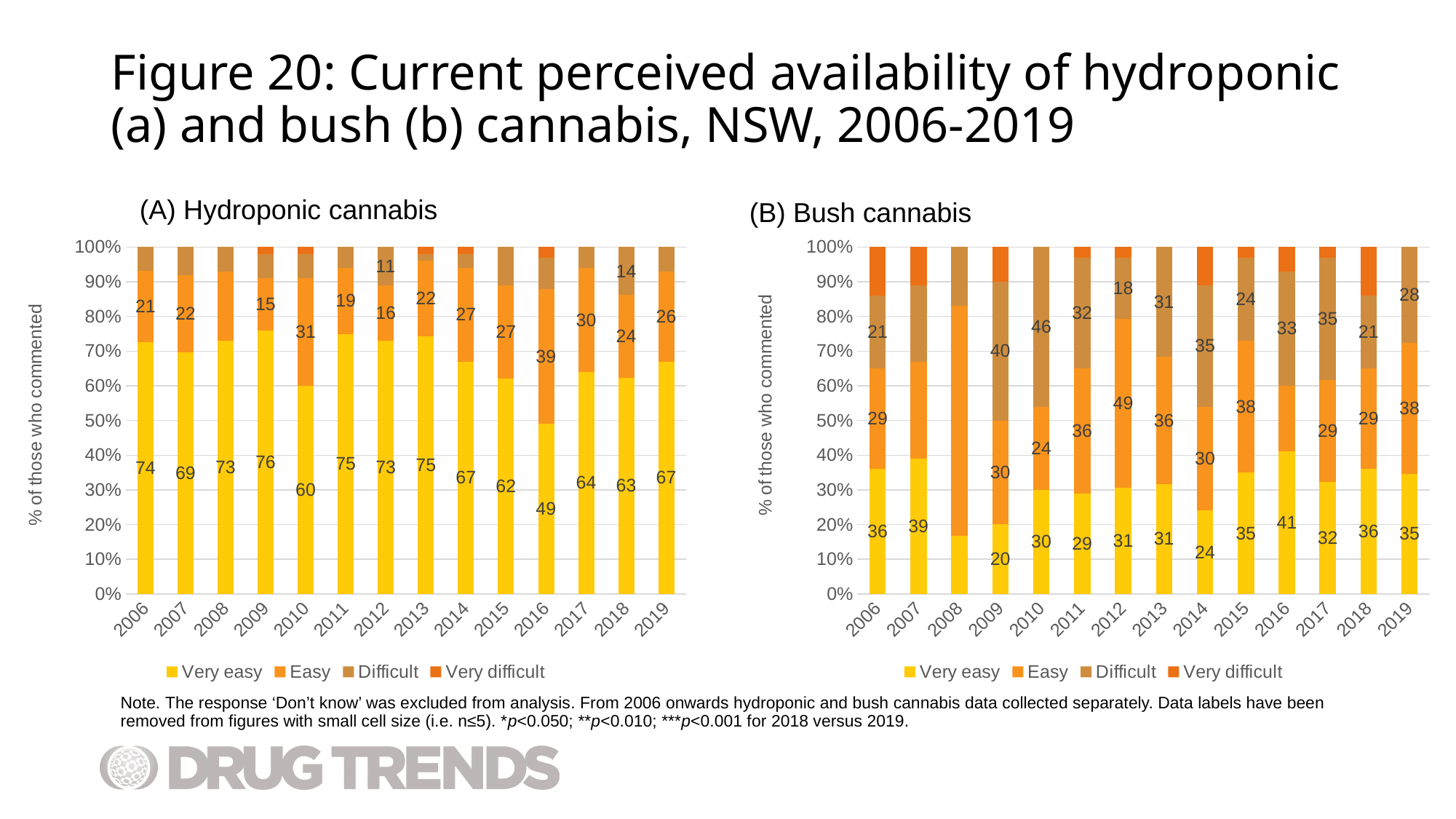
In the Hydroponic cannabis chart, which year has the highest 'Very easy' percentage? 2009 In the Bush cannabis chart, what is the 'Easy' percentage in 2012? 49 In the Hydroponic cannabis chart, which year has the lowest 'Very easy' percentage? 2016 In the Hydroponic cannabis chart, what percentage of respondents rated availability as 'Very easy' in 2016? 49 In the Hydroponic cannabis chart, what is the 'Difficult' percentage in 2018? 14 In the Bush cannabis chart, which is larger: the 'Easy' percentage in 2012 or in 2019? 2012 How many series does the legend of the Bush cannabis chart list? 4 How many years are shown on the x axis of the Hydroponic cannabis chart? 14 In the Hydroponic cannabis chart, what is the difference between the 'Very easy' percentages for 2006 and 2019? 7 In the Bush cannabis chart, which year has the highest 'Very easy' percentage? 2016 What type of chart is the Hydroponic cannabis chart? Stacked bar chart In the Bush cannabis chart, what percentage rated availability as 'Difficult' in 2010? 46